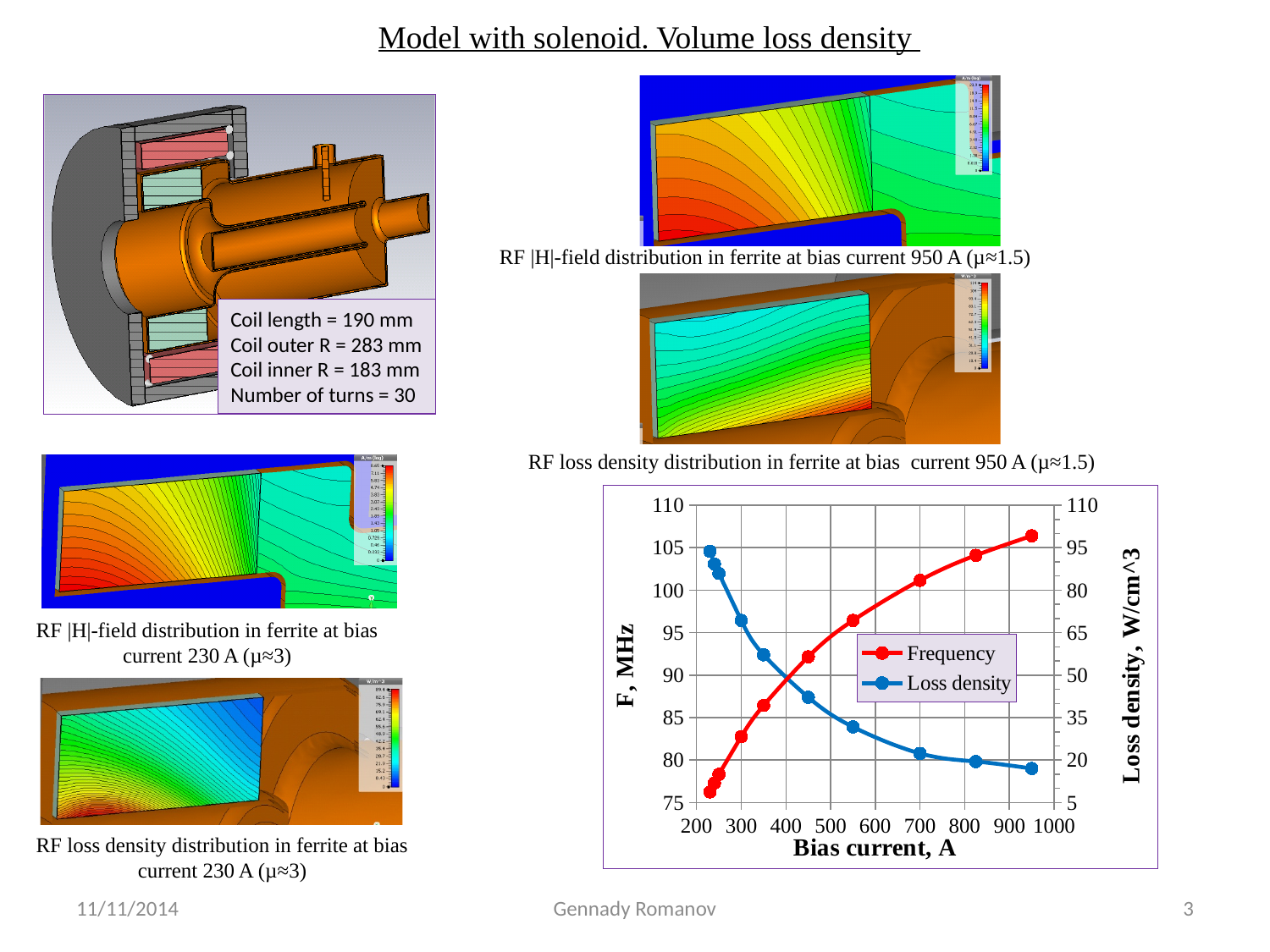
Is the Loss density value at a bias current of about 230 A greater or less than 80 W/cm^3? greater What is the title of the x axis of the chart? Bias current, A Does the Loss density series rise or fall as bias current increases? falls Is the Loss density value at a bias current of 700 A greater or less than 35 W/cm^3? less How many series does the legend of the chart list? 2 Which two series are listed in the chart's legend? Frequency and Loss density Does the Frequency series rise or fall as bias current increases? rises Is the Frequency value at a bias current of 700 A greater or less than 95 MHz? greater What kind of chart is shown at the bottom right of the slide? line chart